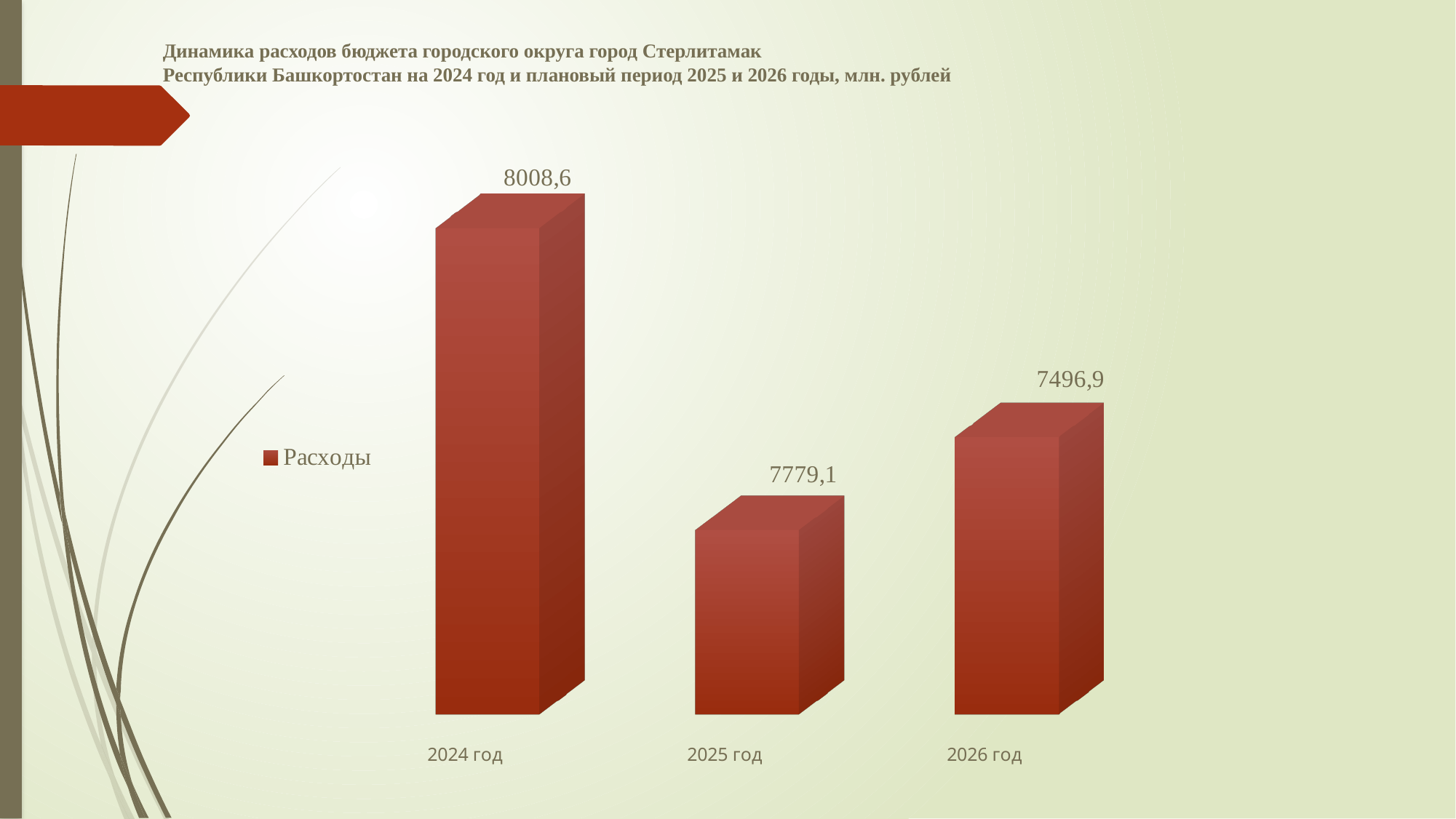
Which is larger, the value for 2024 год or the value for 2025 год? 2024 год What is the difference between the values for 2024 год and 2025 год? 229,5 What is the value for 2025 год? 7779,1 How many categories are shown on the x axis? 3 What kind of chart is shown on the slide? bar chart What is the difference between the values for 2024 год and 2026 год? 511,7 In what units are the values on the chart expressed, according to the title? млн. рублей What is the value for 2026 год? 7496,9 Which year has the highest value? 2024 год What is the value for 2024 год? 8008,6 How many series does the legend list? 1 What is the name of the series shown in the legend? Расходы